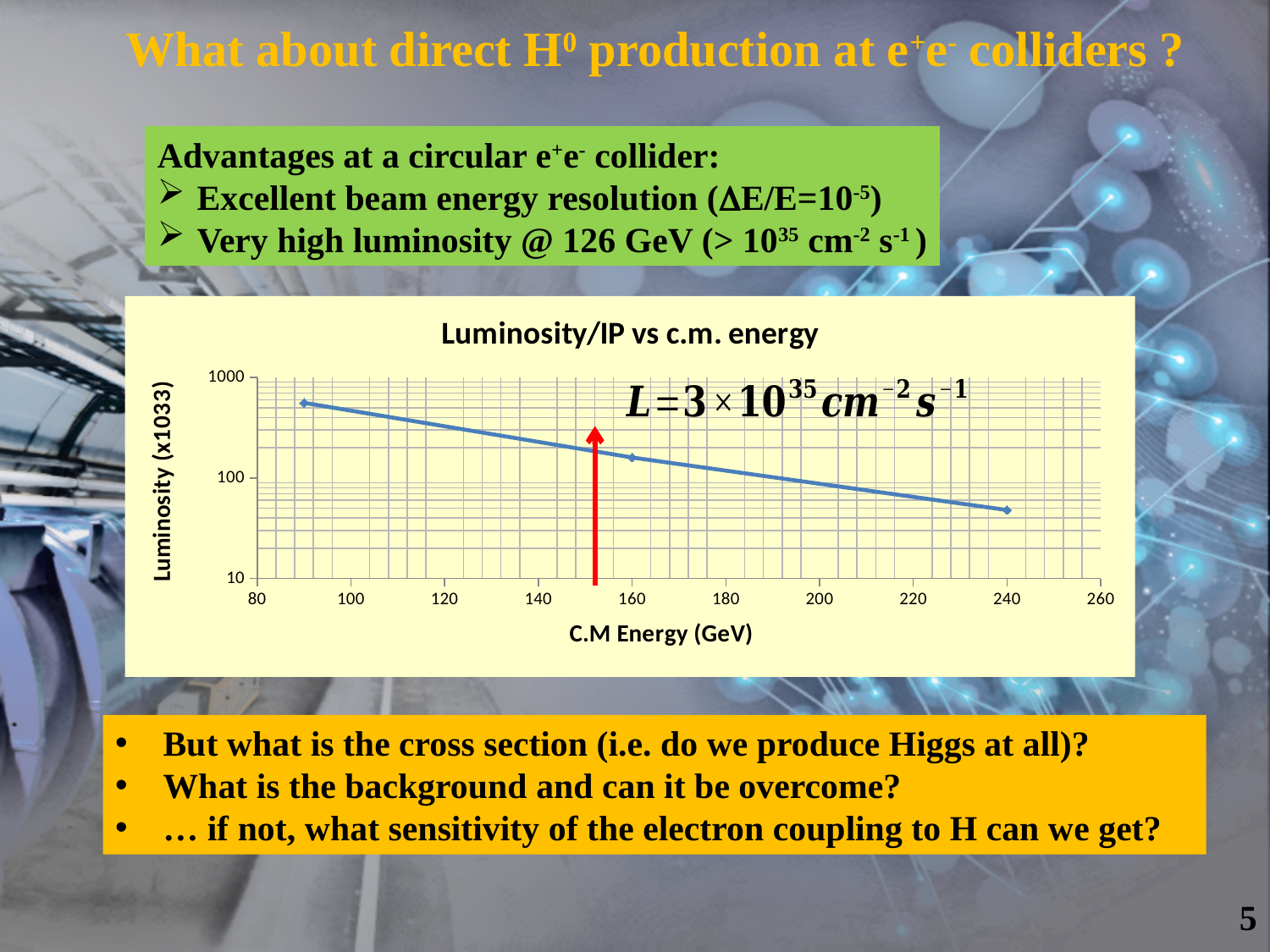
Which data point has the highest luminosity: the one near 90 GeV, near 160 GeV, or near 240 GeV? near 90 GeV Does the luminosity rise or fall as the C.M energy increases along the x axis? fall Is the luminosity value at the rightmost data point (near 240 GeV) greater or less than 100? less What kind of chart is shown on the slide? line chart Is the luminosity value at the leftmost data point (near 90 GeV) greater or less than 100? greater Which data point has the lowest luminosity: the one near 90 GeV, near 160 GeV, or near 240 GeV? near 240 GeV Which has the larger luminosity: the data point near 160 GeV or the data point near 240 GeV? near 160 GeV Is the luminosity value at the middle data point (near 160 GeV) greater or less than 100? greater How many data points are plotted on the line in the chart? 3 What is the label of the x axis of the chart? C.M Energy (GeV) What is the title of the chart? Luminosity/IP vs c.m. energy